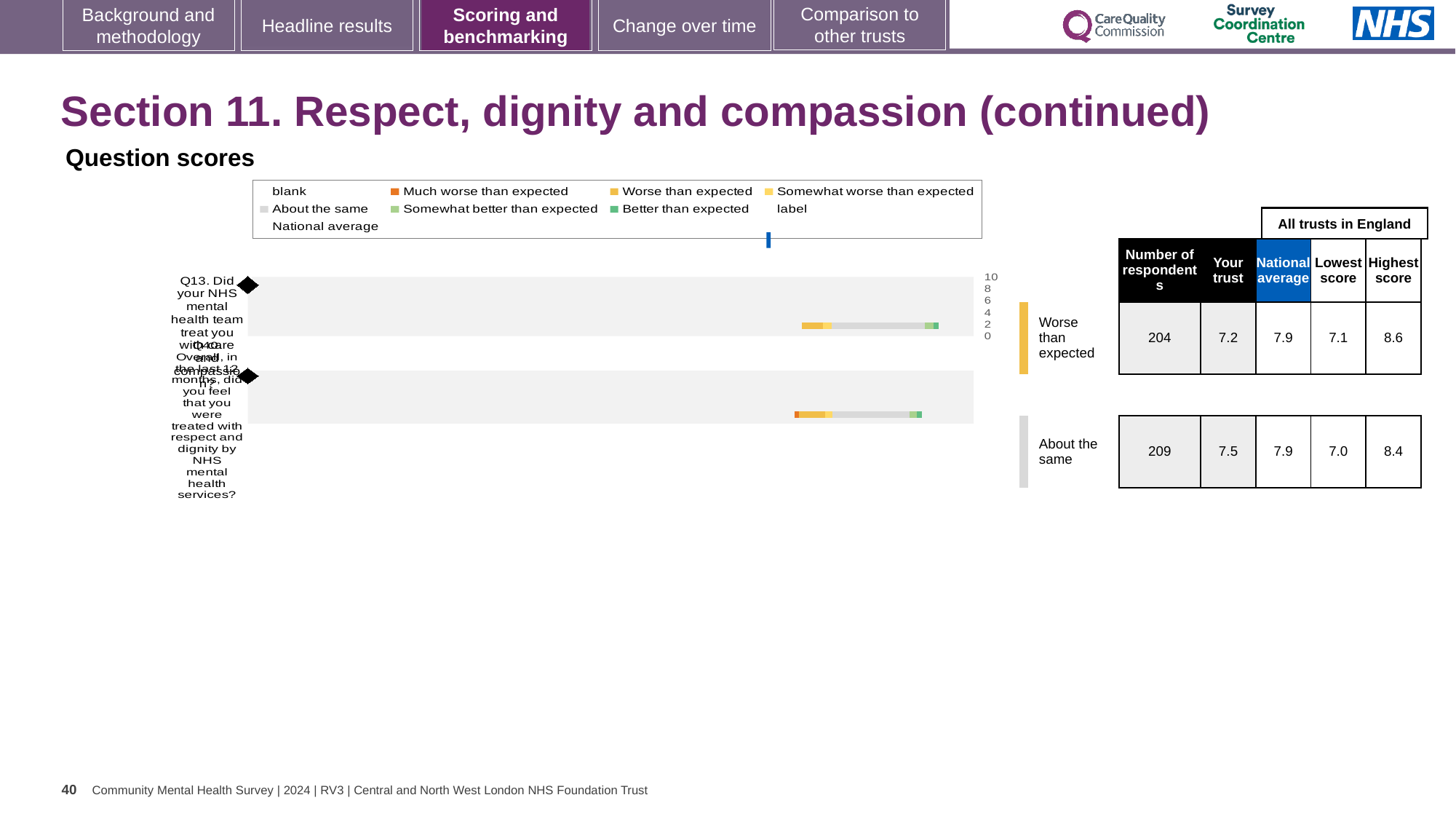
What is the difference between the national average and the 'Your trust' score for Q13? 0.7 What benchmark category is shown for Q13? Worse than expected Which question has the higher 'Your trust' score, Q13 or Q40? Q40 What is the highest score among all trusts in England for Q13? 8.6 What is the lowest score among all trusts in England for Q40? 7.0 What type of chart is used to show the question scores on this slide? bar chart What is the 'Your trust' score for Q13 about being treated with care and compassion? 7.2 How many respondents answered Q40? 209 What is the 'Your trust' score for Q40 about being treated with respect and dignity? 7.5 What is the national average score for Q13? 7.9 How many questions are plotted in the question scores chart? 2 What benchmark category is shown for Q40? About the same